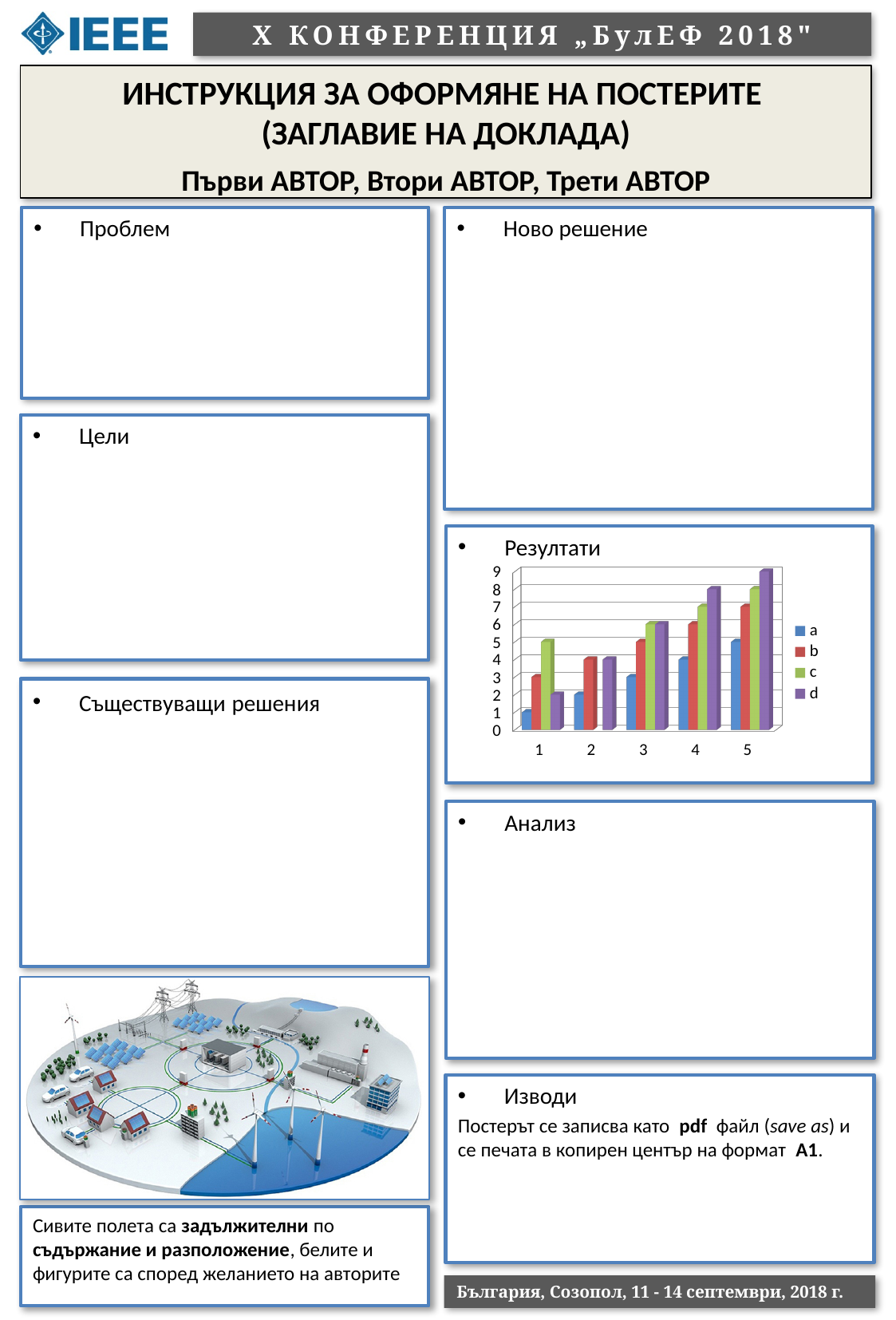
In the chart in the "Резултати" box, which series has the tallest bar at category 5? d In the chart in the "Резултати" box, is the value of series d at category 5 greater or less than 6? greater What kind of chart is shown in the "Резултати" box? bar chart In the chart in the "Резултати" box, which series has the shortest bar at category 1? a In the chart in the "Резултати" box, is the value of series c at category 5 greater or less than 6? greater In the chart in the "Резултати" box, do the values of series a rise or fall from category 1 to category 5? rise How many series does the legend of the chart in the "Резултати" box list? 4 In the chart in the "Резултати" box, which is larger: series c at category 1 or series a at category 1? series c What colour represents series d in the chart in the "Резултати" box? purple In the chart in the "Резултати" box, which is larger: series b at category 5 or series a at category 5? series b How many categories are shown on the x axis of the chart in the "Резултати" box? 5 In the chart in the "Резултати" box, is the value of series a at category 1 greater or less than 2? less